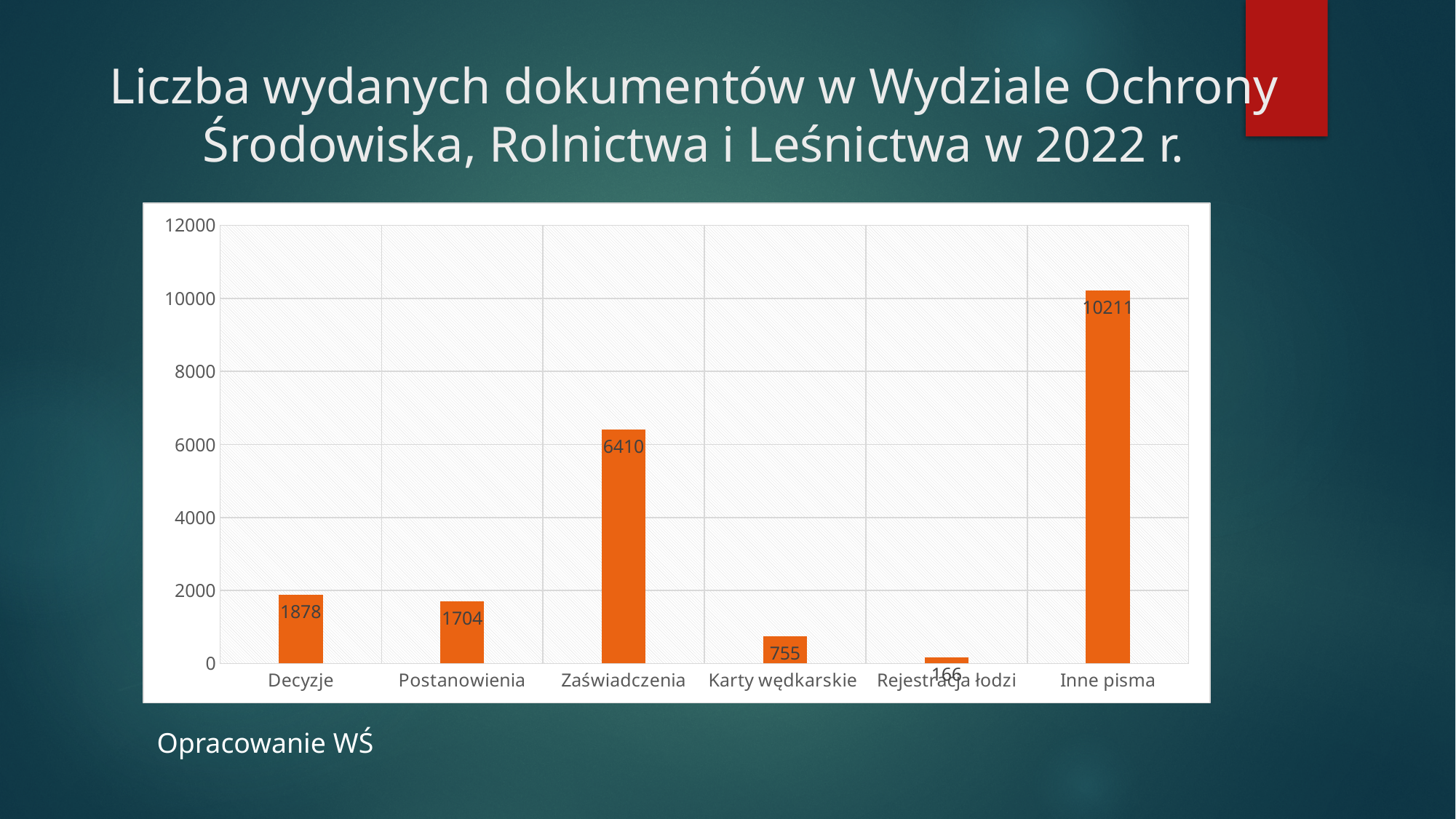
Which is larger, the value for Postanowienia or the value for Karty wędkarskie? Postanowienia What kind of chart is shown on the slide? bar chart Which category has the lowest value? Rejestracja łodzi Is the value for Inne pisma greater or less than 10000? greater What is the difference between the values for Decyzje and Postanowienia? 174 How many categories are shown on the x axis? 6 What is the value for Decyzje? 1878 What is the difference between the values for Inne pisma and Zaświadczenia? 3801 Which category has the highest value? Inne pisma What is the value for Zaświadczenia? 6410 What is the value for Inne pisma? 10211 What is the value for Karty wędkarskie? 755